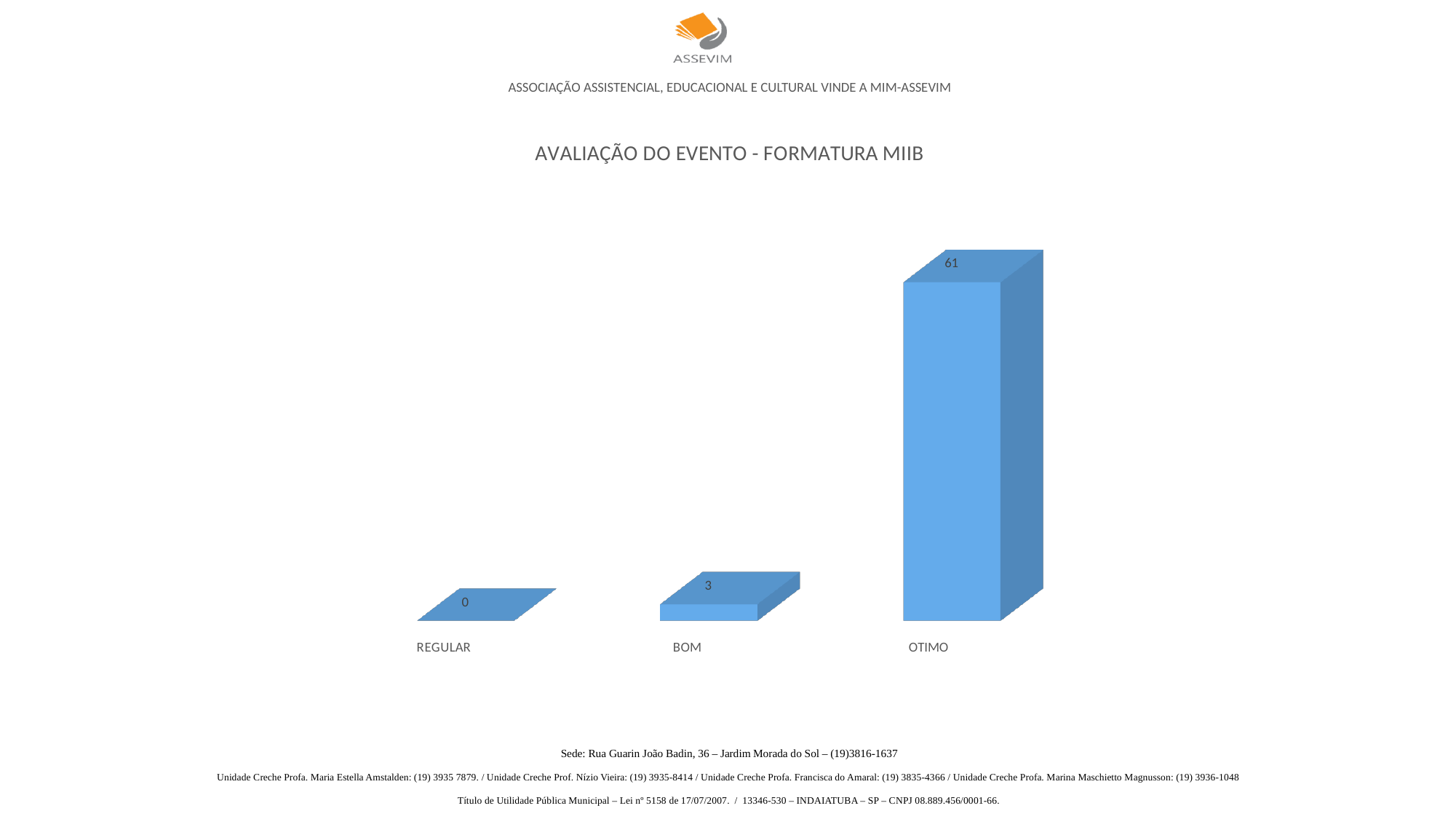
What is the value for REGULAR? 0 Do the values rise or fall from REGULAR to OTIMO along the x axis? Rise What is the value for OTIMO? 61 What is the value for BOM? 3 Which category has the highest value? OTIMO Which is larger, the value for BOM or the value for REGULAR? BOM Which category has the lowest value? REGULAR What is the total of the three values shown on the chart? 64 What is the difference between the values for OTIMO and BOM? 58 How many categories are shown on the chart? 3 What is the title of the chart? AVALIAÇÃO DO EVENTO - FORMATURA MIIB What kind of chart is shown on the slide? Bar chart